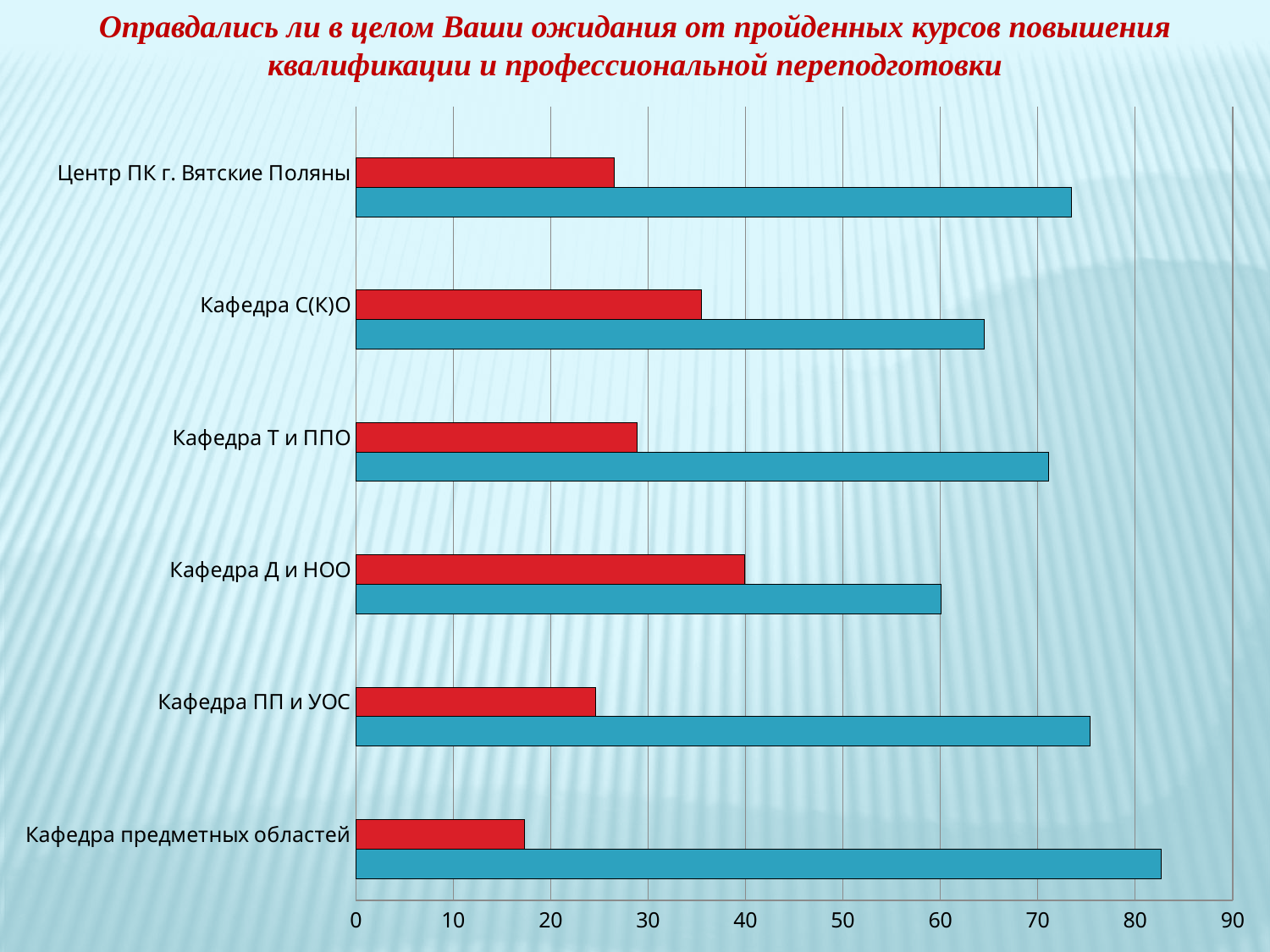
Which category has the longest red bar? Кафедра Д и НОО Is the red bar value for Кафедра С(К)О greater or less than 30? greater Which category has the longest blue bar? Кафедра предметных областей Which has the larger blue bar: Центр ПК г. Вятские Поляны or Кафедра С(К)О? Центр ПК г. Вятские Поляны How many categories are shown on the vertical axis of the chart? 6 Which category has the shortest red bar? Кафедра предметных областей Is the blue bar value for Кафедра предметных областей greater or less than 80? greater Is the red bar value for Центр ПК г. Вятские Поляны greater or less than 30? less What kind of chart is shown on the slide? bar chart Which category has the shortest blue bar? Кафедра Д и НОО Which has the larger red bar: Кафедра С(К)О or Кафедра Т и ППО? Кафедра С(К)О How many bars are plotted for each category in the chart? 2